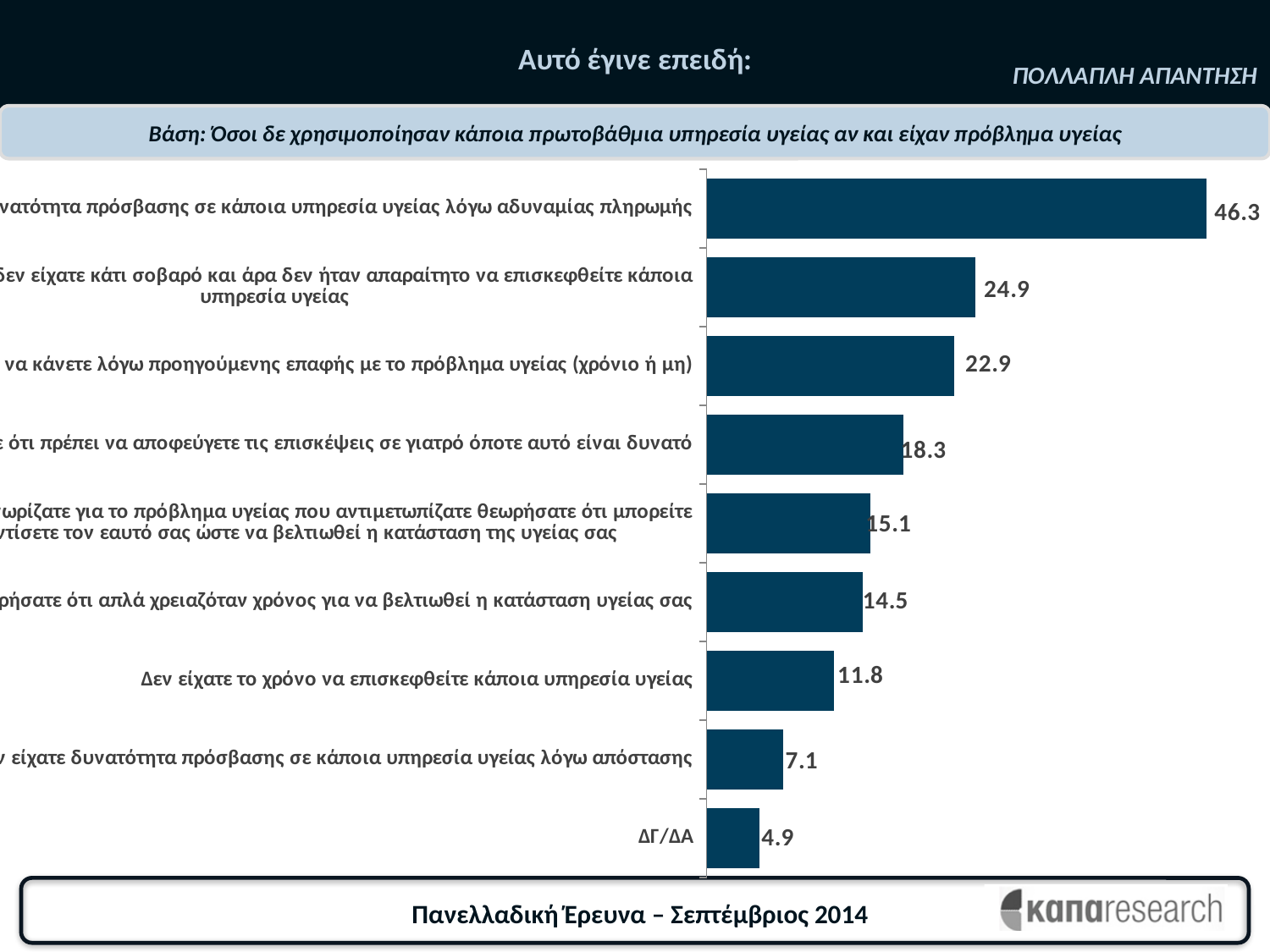
Which is larger: the value for 'Δεν είχατε το χρόνο να επισκεφθείτε κάποια υπηρεσία υγείας' or the value for 'ΔΓ/ΔΑ'? Δεν είχατε το χρόνο να επισκεφθείτε κάποια υπηρεσία υγείας What is the title of the chart at the top of the slide? Αυτό έγινε επειδή: What is the difference between the value for 'Δεν είχατε το χρόνο να επισκεφθείτε κάποια υπηρεσία υγείας' and the value for 'ΔΓ/ΔΑ'? 6.9 What kind of chart is shown on the slide? bar chart What is the second-highest value shown in the chart? 24.9 What is the difference between the highest value and the lowest value in the chart? 41.4 What is the highest value shown in the chart? 46.3 How many categories (bars) does the chart show? 9 Which category has the lowest value in the chart? ΔΓ/ΔΑ What is the value for the category 'ΔΓ/ΔΑ'? 4.9 What is the value for the category 'Δεν είχατε το χρόνο να επισκεφθείτε κάποια υπηρεσία υγείας'? 11.8 What text appears in the footer bar at the bottom of the slide? Πανελλαδική Έρευνα – Σεπτέμβριος 2014